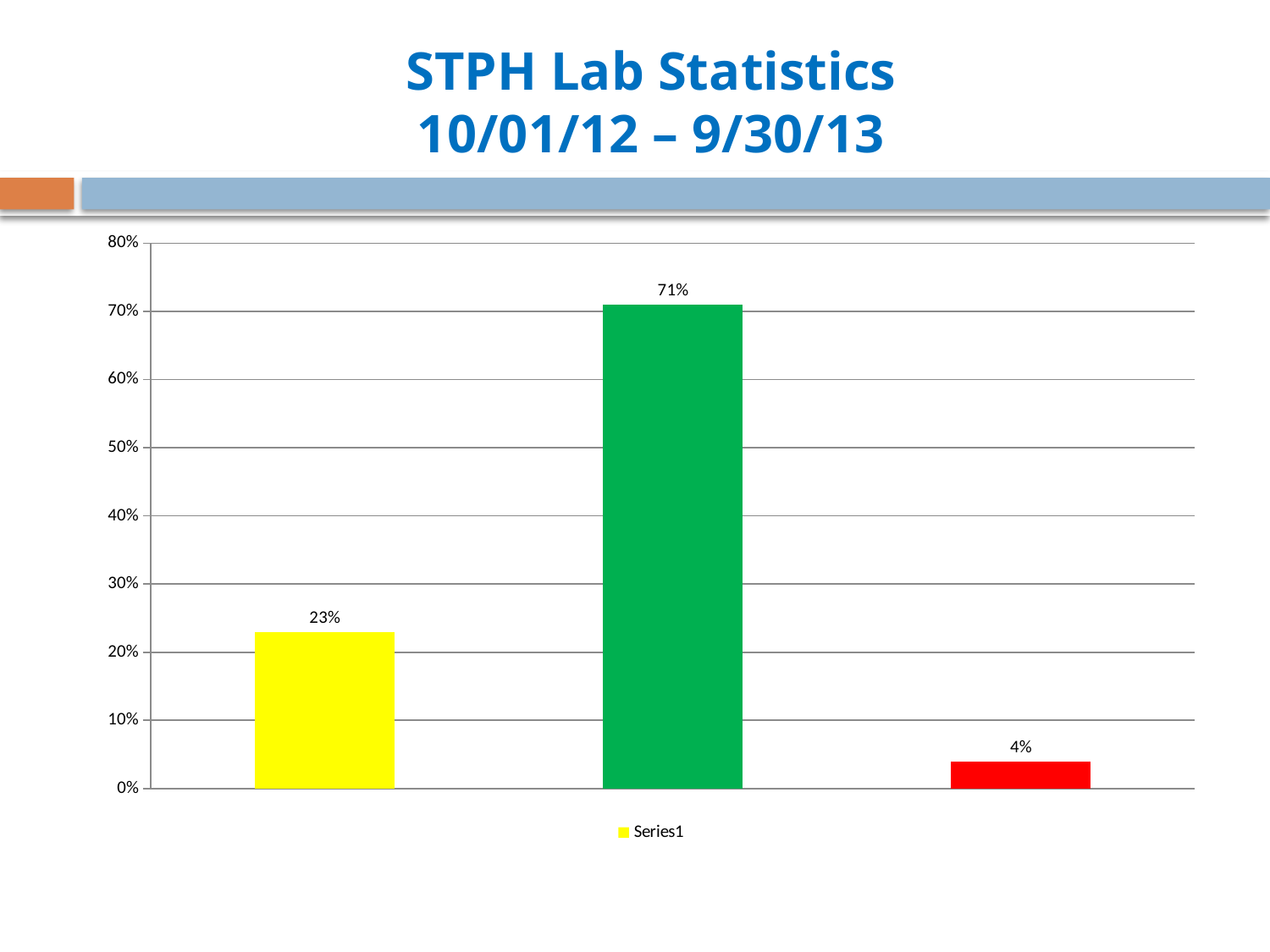
How many bars are plotted in the chart? 3 What value is shown on the red bar? 4% What is the difference between the yellow bar and the red bar? 19% Which bar has the highest value? The green bar (71%) What value is shown on the green bar? 71% What type of chart is shown on the slide? Bar chart What series name does the legend show? Series1 Which bar has the lowest value? The red bar (4%) Is the value of the green bar greater or less than 60%? greater Which is larger, the yellow bar or the red bar? The yellow bar What value is shown on the yellow bar? 23% What is the difference between the green bar and the yellow bar? 48%